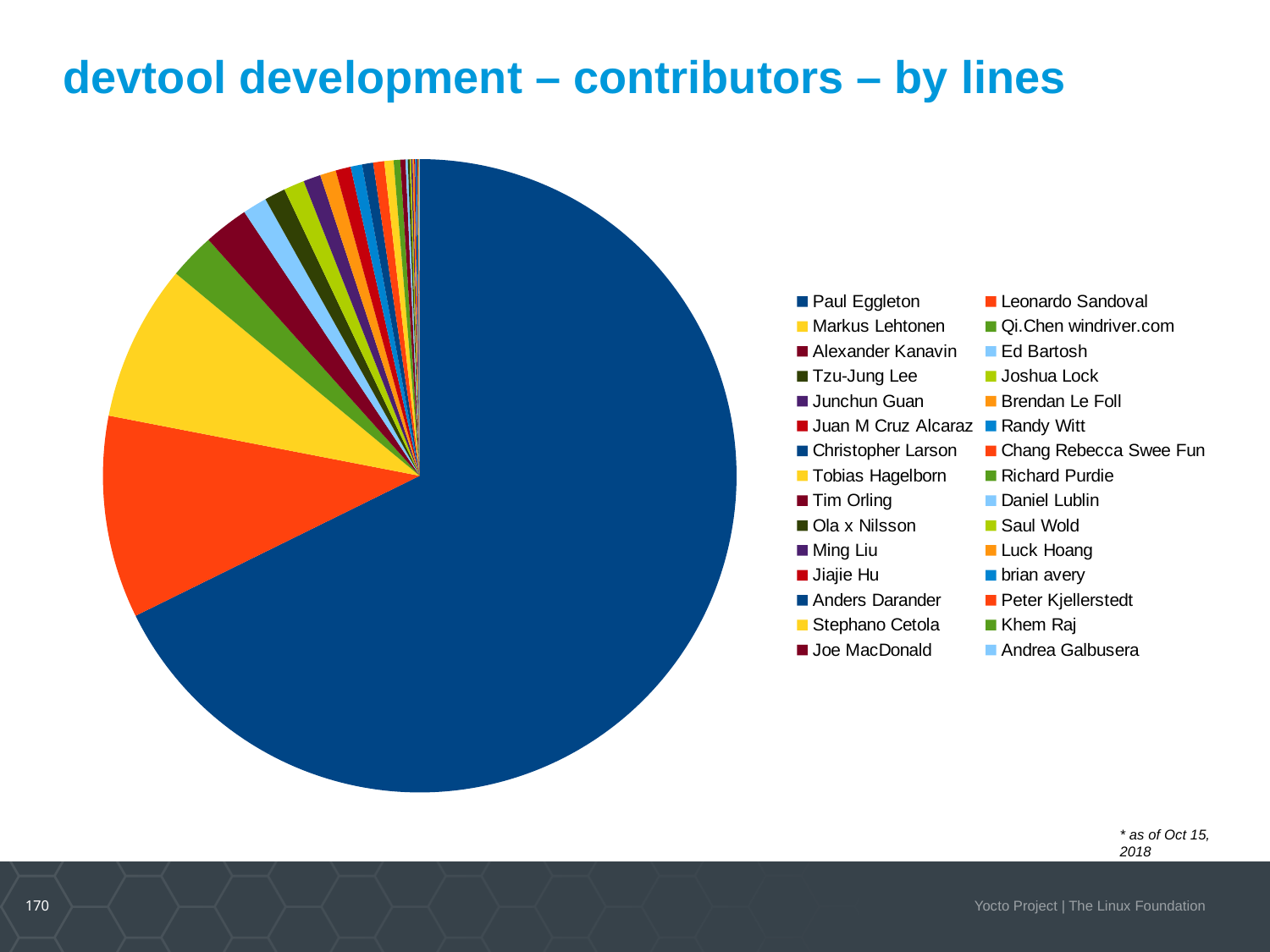
What colour is the slice for Paul Eggleton in the pie chart? dark blue Which contributor has the largest slice of the pie chart? Paul Eggleton How many contributors are listed in the legend of the pie chart? 30 What kind of chart is shown on the slide? pie chart Which contributor is listed first in the legend of the pie chart? Paul Eggleton Which slice is larger, Paul Eggleton or Leonardo Sandoval? Paul Eggleton Which slice is larger, Leonardo Sandoval or Markus Lehtonen? Leonardo Sandoval What is the title of the slide containing the pie chart? devtool development – contributors – by lines Which contributor has the second-largest slice of the pie chart? Leonardo Sandoval Is Paul Eggleton's slice greater or less than half of the pie? greater Which slice is larger, Markus Lehtonen or Qi.Chen windriver.com? Markus Lehtonen